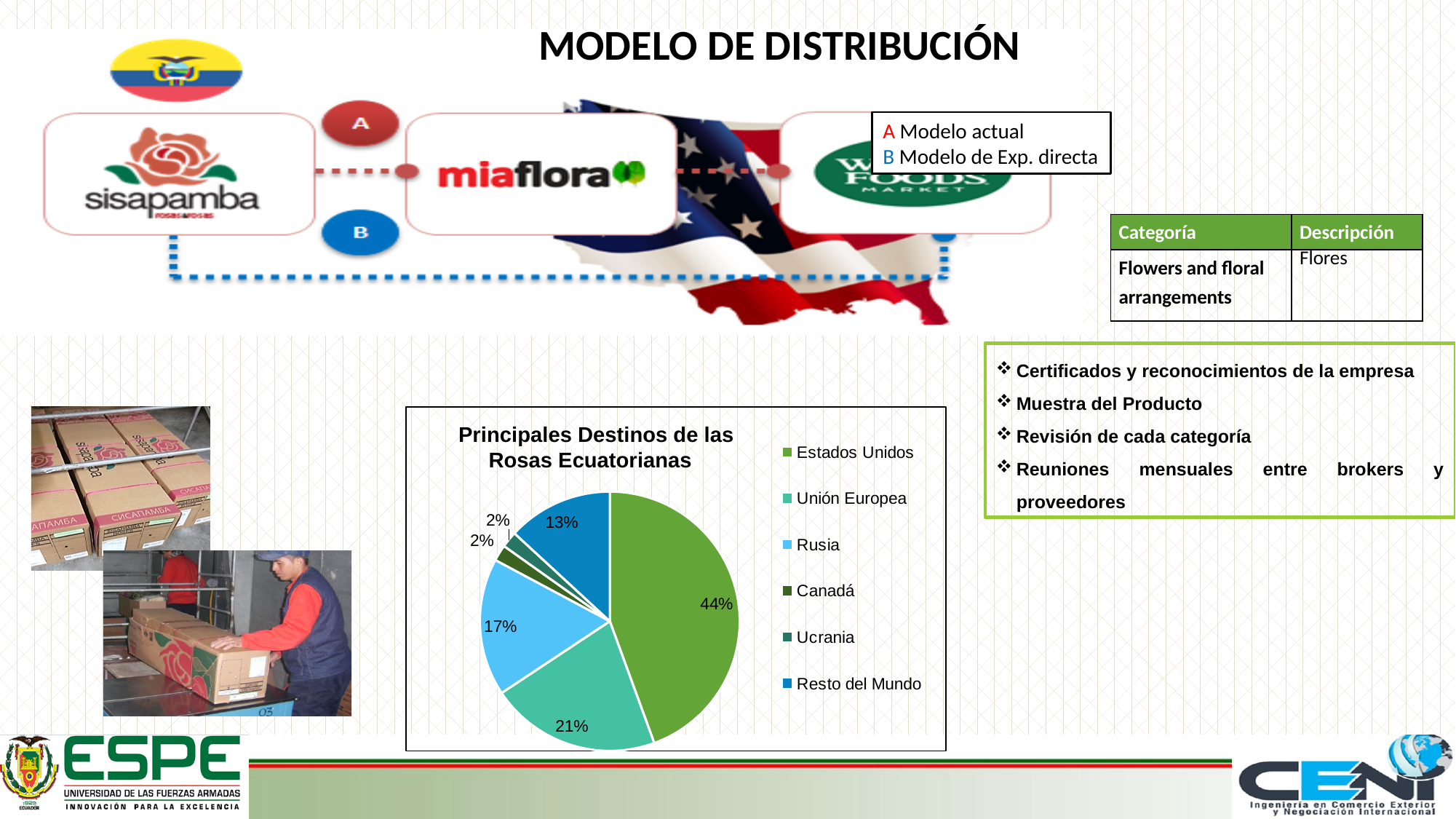
Which is larger, the share for Rusia or the share for Resto del Mundo? Rusia What is the value shown for Rusia? 17% What is the combined share of Canadá and Ucrania? 4% What is the value shown for Canadá? 2% What share of the pie does Estados Unidos represent? 44% What is the value shown for Unión Europea? 21% What is the value shown for Resto del Mundo? 13% What is the title of the pie chart? Principales Destinos de las Rosas Ecuatorianas What type of chart is shown on the slide? pie chart Which destination has the largest share of the pie? Estados Unidos How many categories does the pie chart show? 6 What is the difference between the shares of Estados Unidos and Unión Europea? 23%